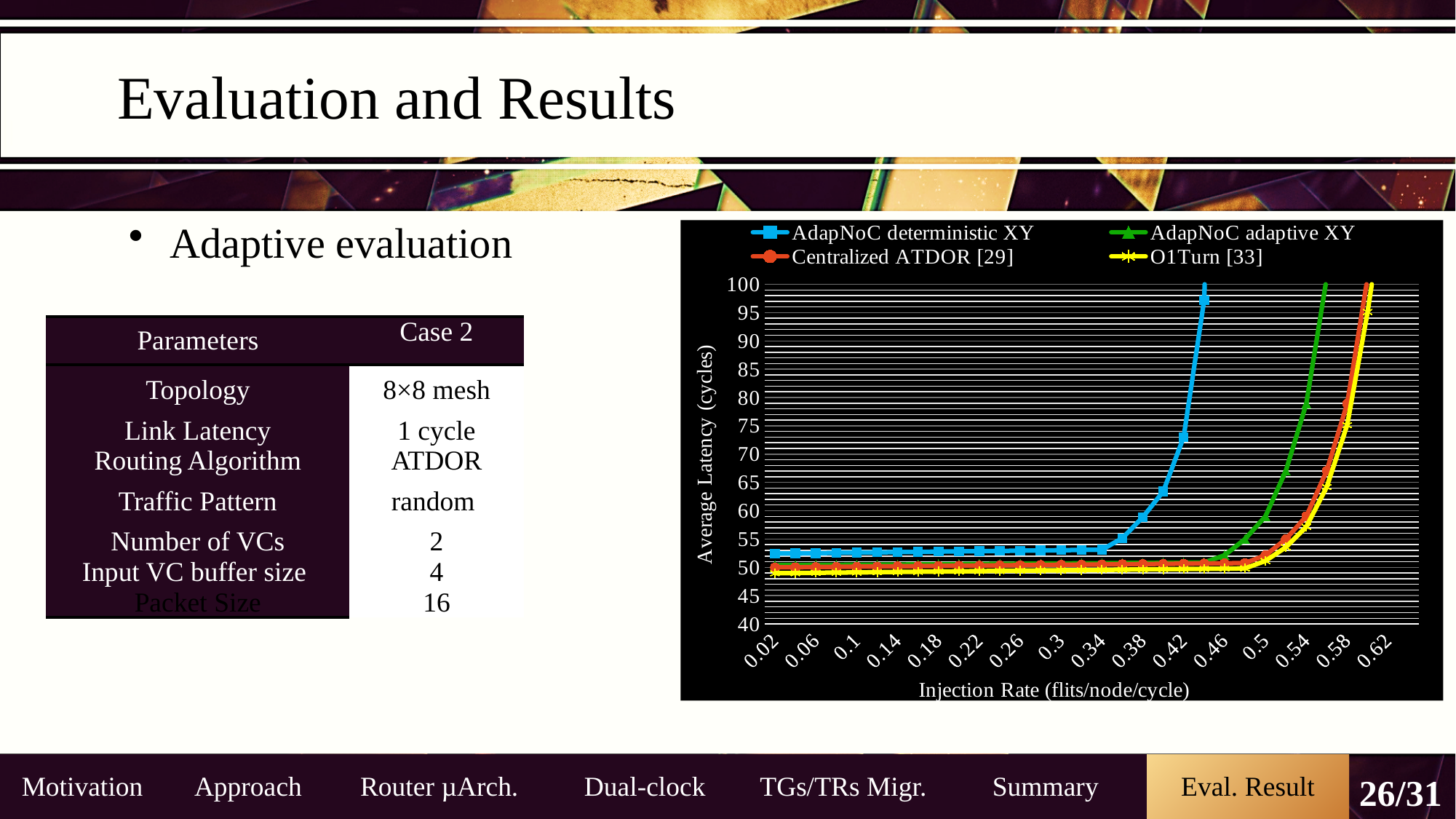
At an injection rate of 0.5, which series has the higher average latency: AdapNoC adaptive XY or Centralized ATDOR [29]? AdapNoC adaptive XY How many injection rate values are labelled on the x axis? 16 Is the average latency for AdapNoC adaptive XY at an injection rate of 0.46 greater or less than 55? less What is the title of the chart's x axis? Injection Rate (flits/node/cycle) At an injection rate of 0.42, which series has the higher average latency: AdapNoC deterministic XY or AdapNoC adaptive XY? AdapNoC deterministic XY Is the average latency for AdapNoC deterministic XY at an injection rate of 0.42 greater or less than 70? greater How many series does the chart legend list? 4 Does the average latency for AdapNoC deterministic XY rise or fall as the injection rate increases? rise Is the average latency for O1Turn [33] at an injection rate of 0.5 greater or less than 55? less Which series reaches an average latency of 100 cycles at the lowest injection rate? AdapNoC deterministic XY What is the title of the chart's y axis? Average Latency (cycles) What kind of chart is shown on the slide? line chart